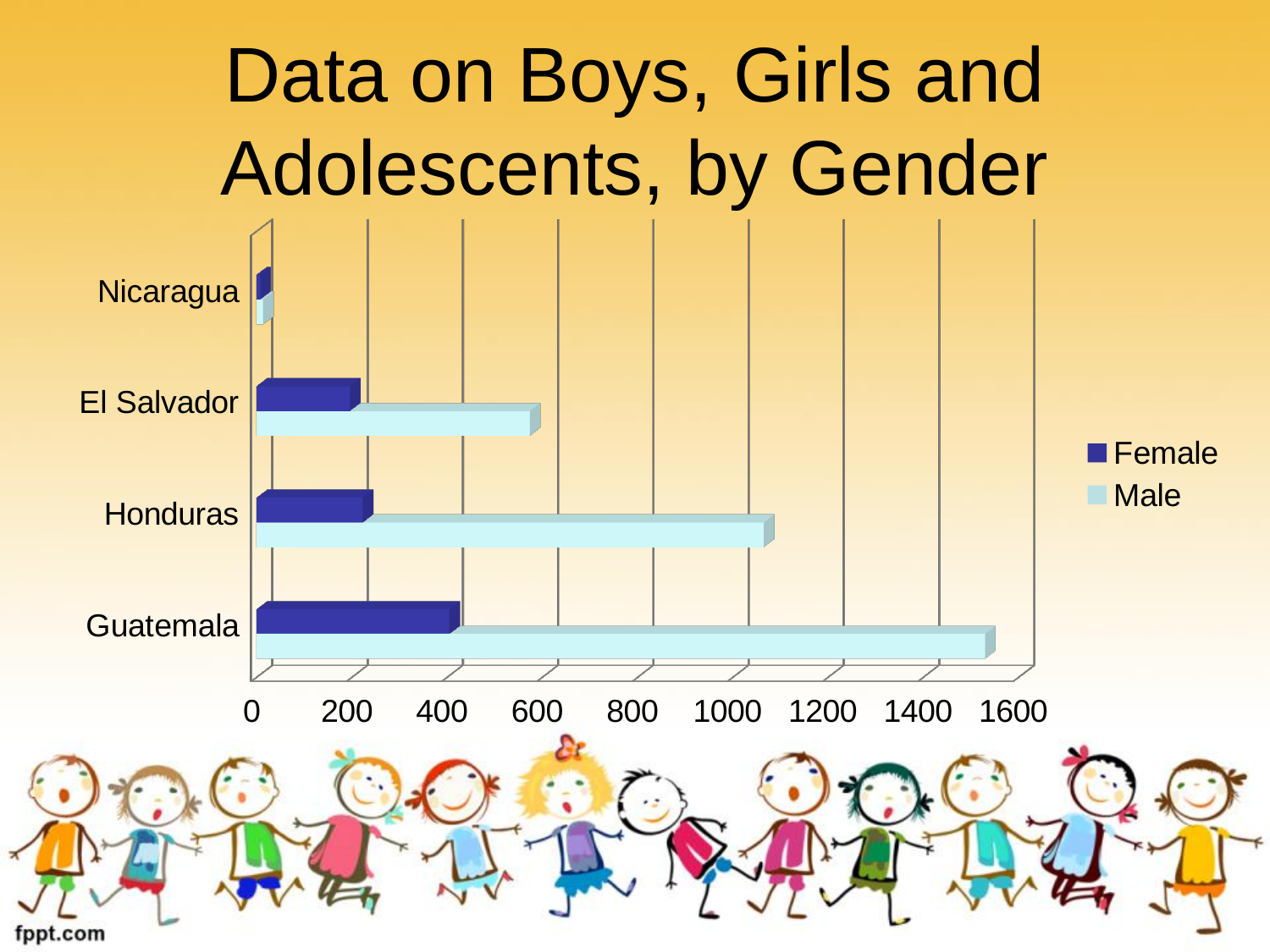
How many series does the legend list? 2 Is the Female value for Guatemala greater or less than 600? less What kind of chart is shown on the slide? bar chart Which country has the lowest Male value? Nicaragua Is the Male value for Nicaragua greater or less than 200? less Is the Male value for Guatemala greater or less than 1400? greater Which country has the highest Female value? Guatemala Which is larger, the Male value for Honduras or the Male value for El Salvador? Honduras What is the title of the chart on the slide? Data on Boys, Girls and Adolescents, by Gender Which country has the highest Male value? Guatemala How many countries are shown on the chart? 4